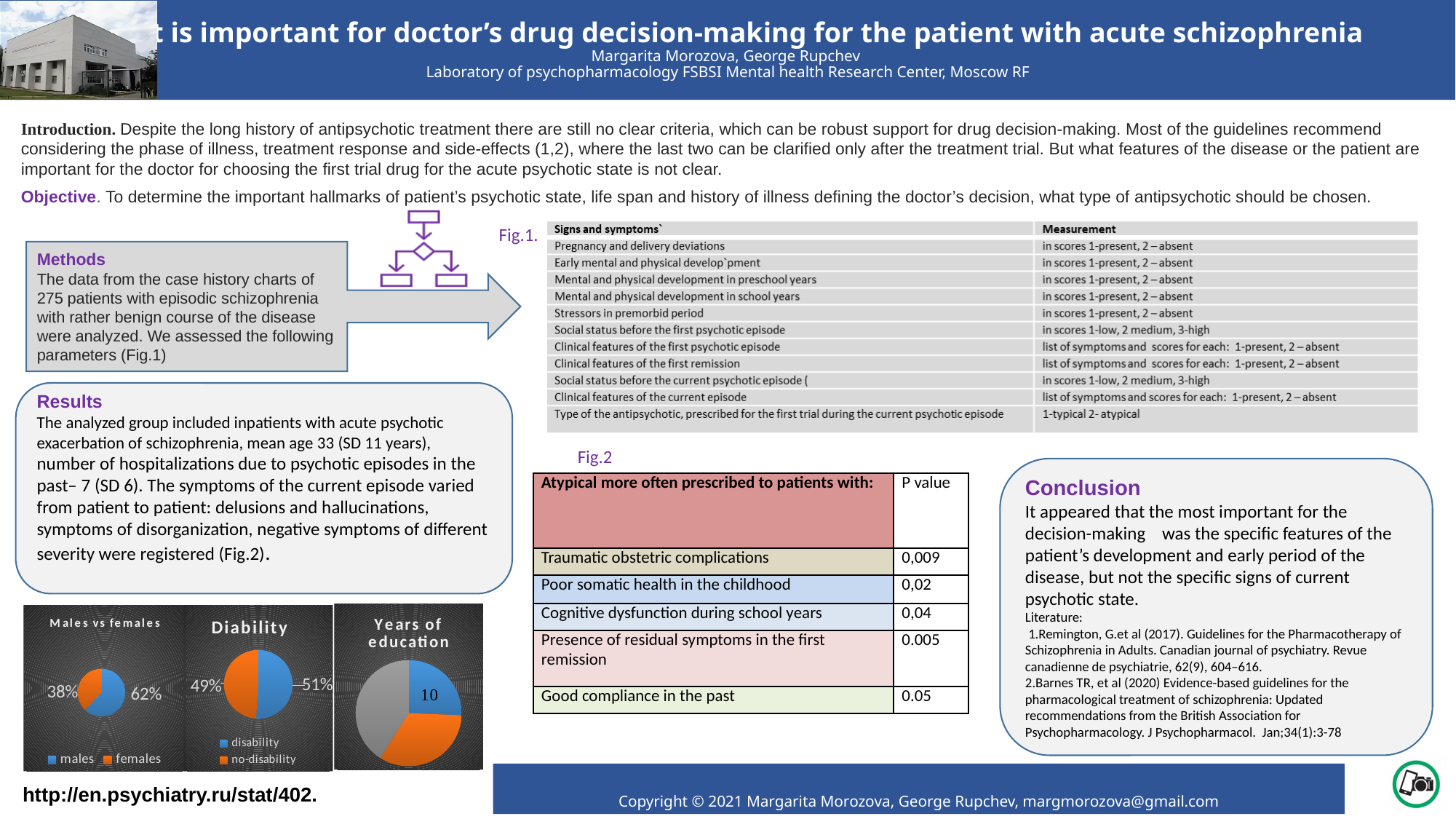
How many entries does the legend of the 'Males vs females' chart list? 2 In the 'Diability' chart, what percentage is shown for no-disability? 49% In the 'Males vs females' chart, which group has the larger share? males What value is printed on the blue slice of the 'Years of education' chart? 10 How many slices does the 'Years of education' pie chart have? 3 In the 'Males vs females' chart, what percentage is shown for males? 62% What kind of chart is the 'Males vs females' chart? pie chart In the 'Males vs females' chart, what is the difference in percentage points between males and females? 24 In the 'Diability' chart, what percentage is shown for disability? 51% In the 'Diability' chart, which legend entry is shown in orange? no-disability In the 'Males vs females' chart, what percentage is shown for females? 38% In the 'Diability' chart, what is the difference in percentage points between disability and no-disability? 2